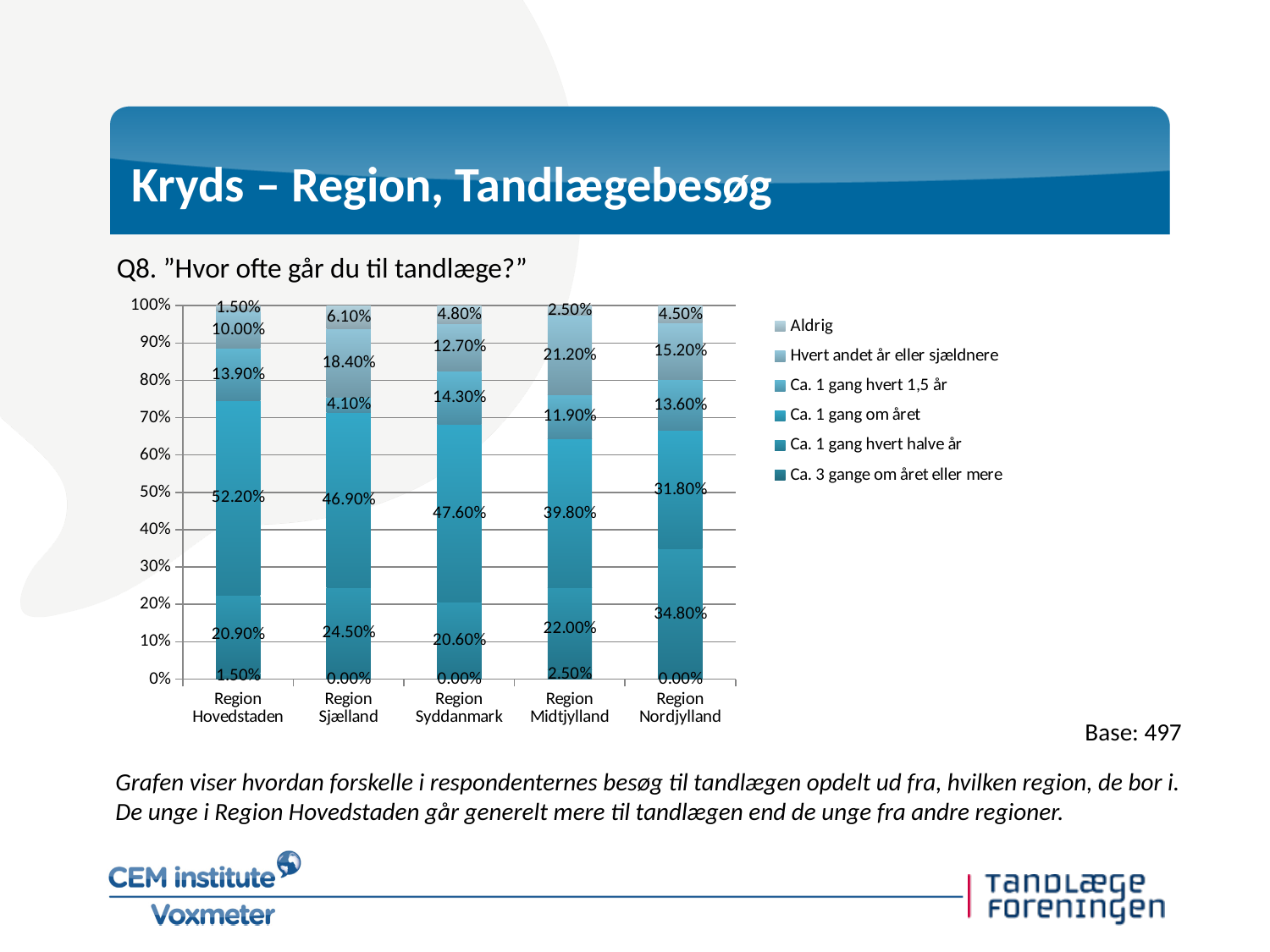
Which region has the lowest value for "Ca. 1 gang om året"? Region Nordjylland What is the value for "Ca. 3 gange om året eller mere" in Region Midtjylland? 2.50% What kind of chart is shown on the slide? Stacked bar chart Which region has the larger "Aldrig" value, Region Sjælland or Region Syddanmark? Region Sjælland How many series does the legend list? 6 How many regions are shown on the x axis? 5 What is the value for "Ca. 1 gang om året" in Region Hovedstaden? 52.20% What is the value for "Ca. 1 gang hvert 1,5 år" in Region Sjælland? 4.10% What is the difference in percentage points between the "Hvert andet år eller sjældnere" values for Region Midtjylland and Region Hovedstaden? 11.20 percentage points What is the value for "Ca. 1 gang hvert halve år" in Region Nordjylland? 34.80% Which region has the highest value for "Ca. 1 gang om året"? Region Hovedstaden Which region has the highest value for "Hvert andet år eller sjældnere"? Region Midtjylland